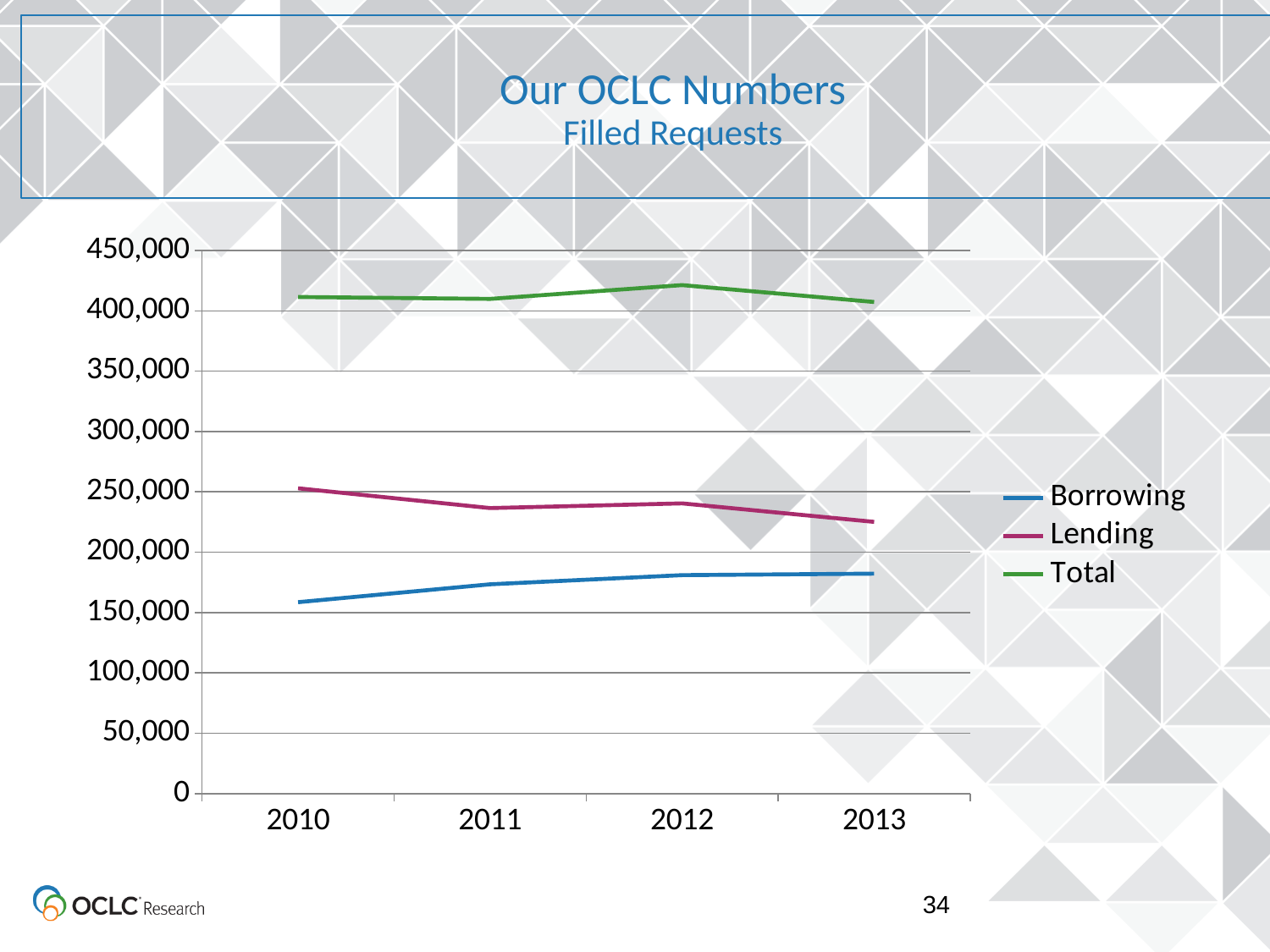
In 2012, which is larger, Lending or Borrowing? Lending In which year is the Lending value highest? 2010 Is the Lending value for 2013 greater or less than 250,000? less Does the Lending line rise or fall from 2010 to 2013? falls Is the Borrowing value for 2010 greater or less than 200,000? less What kind of chart is shown on the slide? line chart How many series does the legend list? 3 Does the Borrowing line rise or fall from 2010 to 2013? rises How many years are plotted along the x axis? 4 In which year is the Borrowing value lowest? 2010 What is the subtitle of the chart shown under 'Our OCLC Numbers'? Filled Requests Is the Total value for 2012 greater or less than 400,000? greater